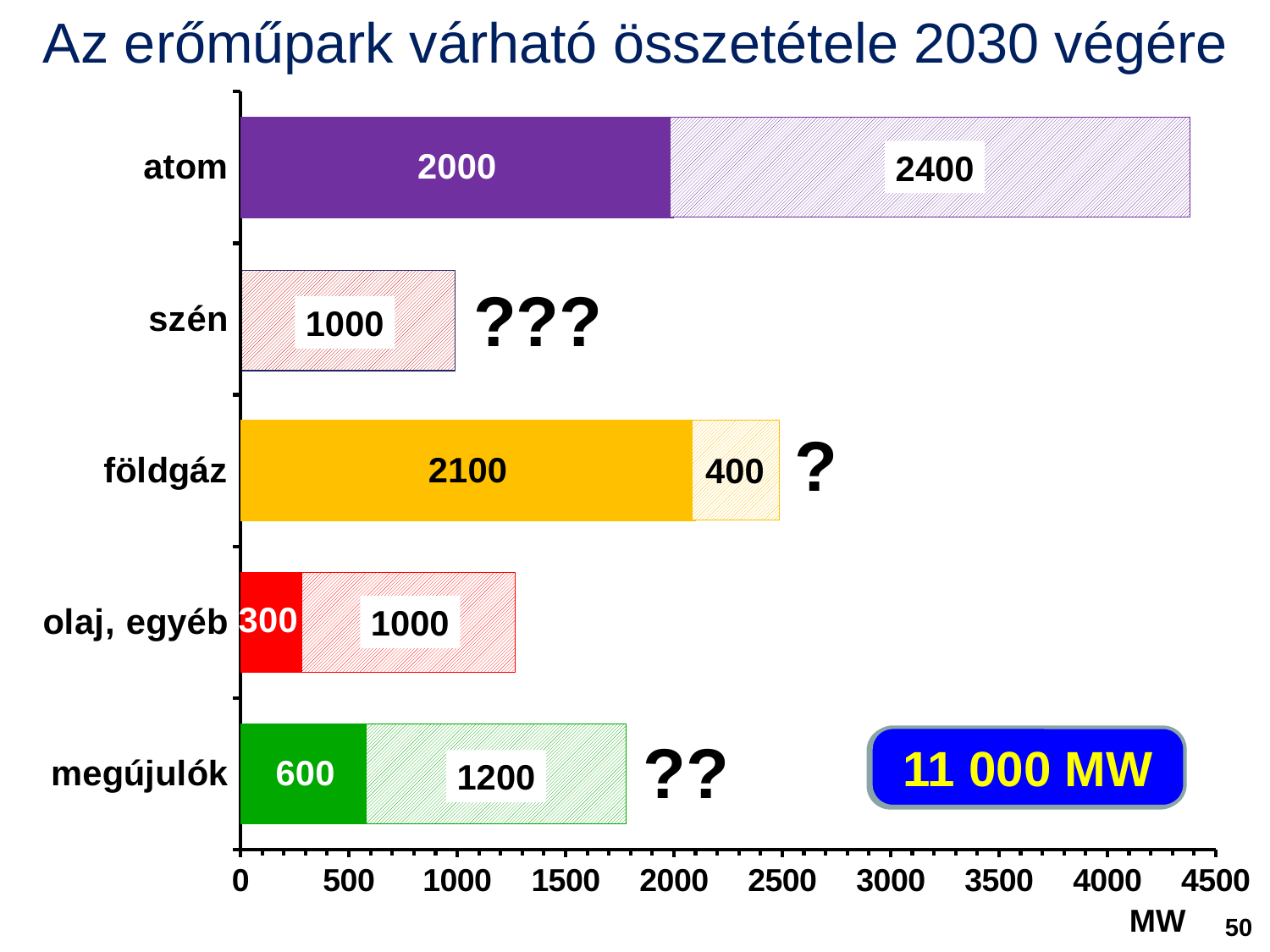
What is the value of the hatched segment for földgáz? 400 Which category has the longest bar in total? atom How many categories are shown on the chart? 5 What is the title of the chart? Az erőműpark várható összetétele 2030 végére What is the value of the solid segment for olaj, egyéb? 300 What type of chart is shown on the slide? bar chart What is the value of the hatched segment for atom? 2400 What is the difference between the solid segment for földgáz and the solid segment for megújulók? 1500 What is the total of the stacked bar for megújulók? 1800 What is the value of the solid segment for atom? 2000 What is the total of the stacked bar for földgáz? 2500 What is the total of the stacked bar for atom? 4400